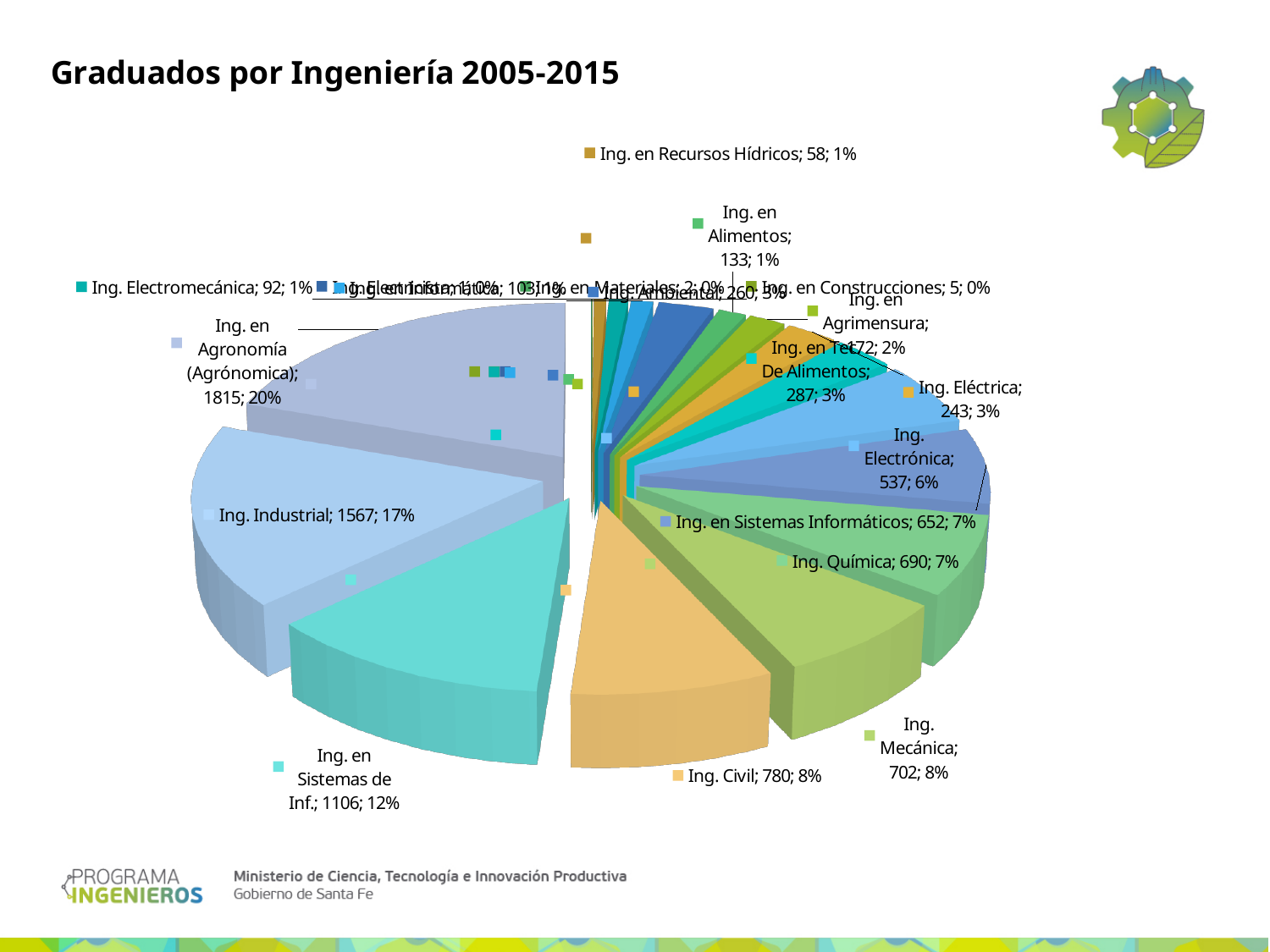
What kind of chart is shown on the slide? pie chart Which engineering has the largest slice of the pie? Ing. en Agronomía (Agrónomica) What percentage of the pie is Ing. en Sistemas de Inf.? 12% What share of the pie does Ing. en Agronomía (Agrónomica) represent? 20% How many graduates are shown for Ing. en Recursos Hídricos? 58 Which has more graduates, Ing. Química or Ing. en Sistemas Informáticos? Ing. Química How many graduates are shown for Ing. Civil? 780 How many graduates are shown for Ing. Electrónica? 537 What is the difference in graduates between Ing. Mecánica and Ing. Eléctrica? 459 What is the title of the chart? Graduados por Ingeniería 2005-2015 What is the difference in graduates between Ing. en Agronomía (Agrónomica) and Ing. Industrial? 248 How many graduates does the chart show for Ing. Industrial? 1567